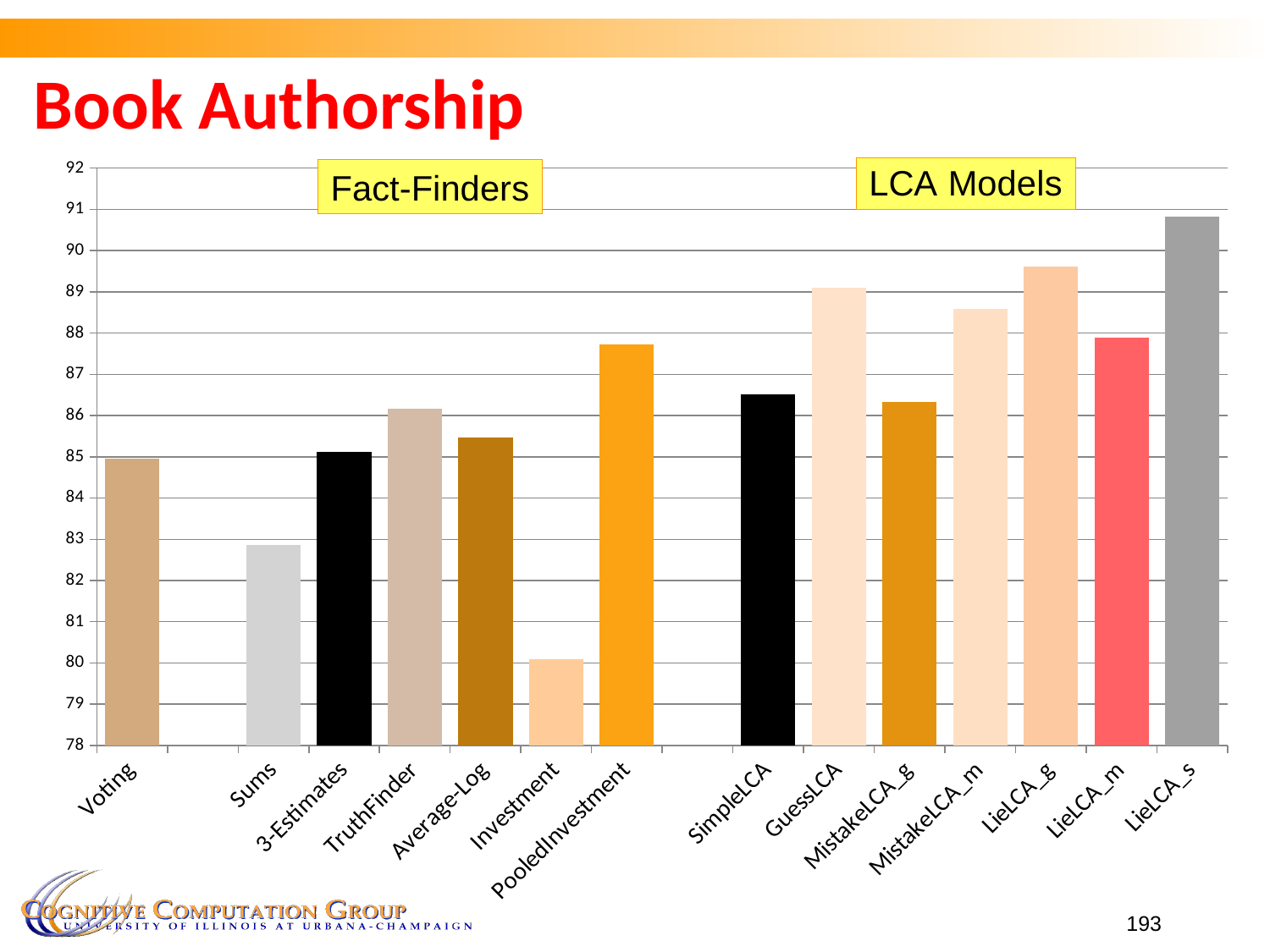
Which has the larger value, LieLCA_g or LieLCA_m? LieLCA_g Is the value for PooledInvestment greater or less than 87? greater Is the value for Investment greater or less than 81? less How many categories (bars) are plotted in the chart? 14 Is the value for LieLCA_s greater or less than 90? greater What kind of chart is shown on the slide? bar chart Which has the larger value, PooledInvestment or TruthFinder? PooledInvestment What are the two group labels shown above the bars in the chart? Fact-Finders and LCA Models Which category has the lowest value in the chart? Investment Which category has the highest value in the chart? LieLCA_s